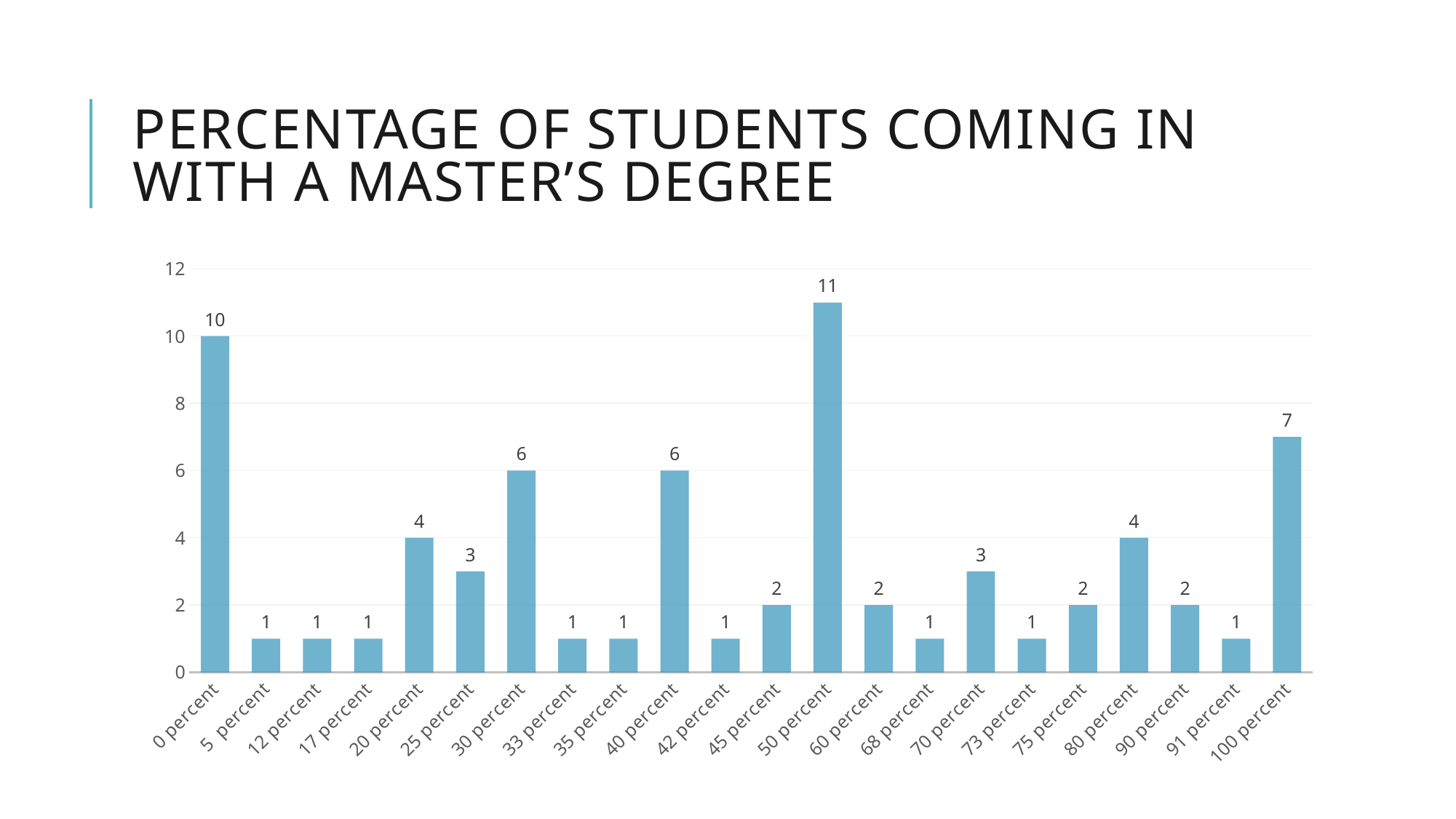
What is the value for the 50 percent category? 11 Which category has the highest value? 50 percent What kind of chart is shown on the slide? Bar chart What is the difference between the values for 100 percent and 30 percent? 1 What is the value for the 0 percent category? 10 Which is larger, the value for 20 percent or the value for 45 percent? 20 percent Which is larger, the value for 25 percent or the value for 70 percent? They are equal (3) What is the value for the 100 percent category? 7 What is the title of the chart on the slide? Percentage of Students Coming In With a Master's Degree What is the value for the 80 percent category? 4 How many categories are shown on the x axis? 22 What is the difference between the values for 50 percent and 0 percent? 1